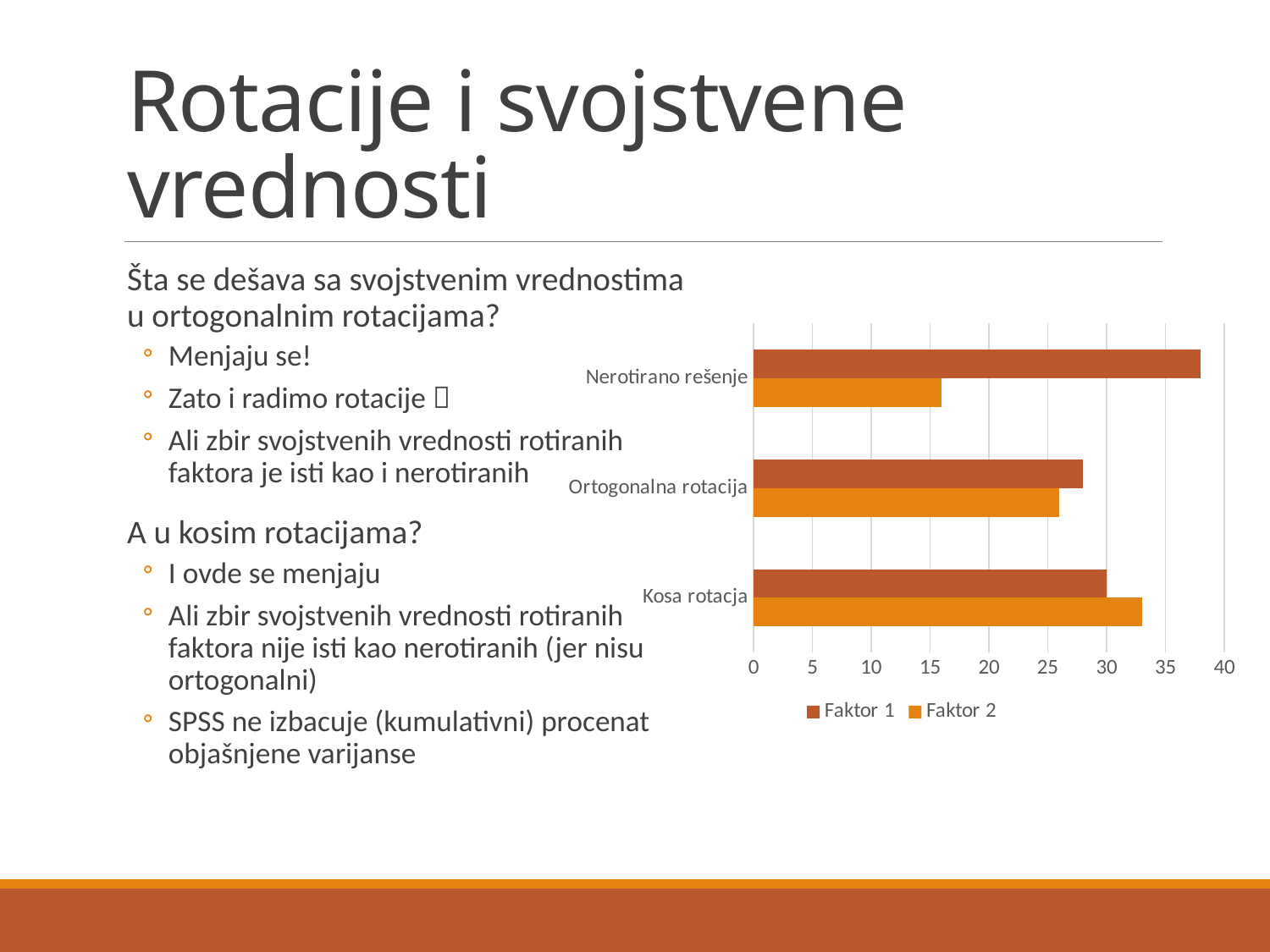
Which category has the highest value for Faktor 1? Nerotirano rešenje For Kosa rotacja, which is larger: Faktor 1 or Faktor 2? Faktor 2 Which category has the lowest value for Faktor 2? Nerotirano rešenje Is the value of Faktor 1 for Nerotirano rešenje greater or less than 35? greater How many series does the chart's legend list? 2 What are the names of the two series in the chart's legend? Faktor 1 and Faktor 2 For Nerotirano rešenje, which is larger: Faktor 1 or Faktor 2? Faktor 1 Is the value of Faktor 2 for Nerotirano rešenje greater or less than 20? less How many categories are shown on the chart? 3 Is the value of Faktor 1 for Ortogonalna rotacija greater or less than 30? less Which category has the highest value for Faktor 2? Kosa rotacja What kind of chart is shown on the slide? bar chart